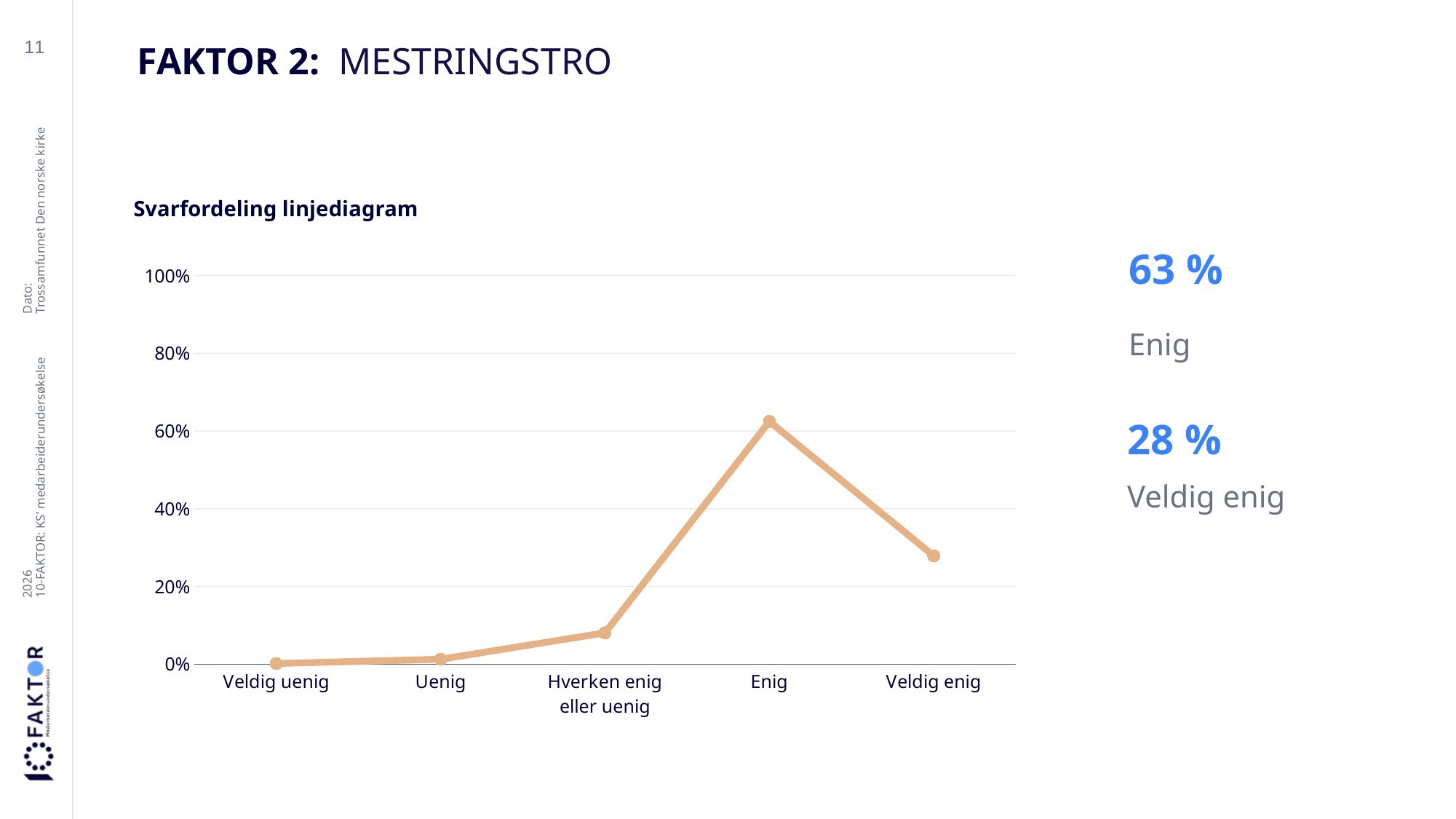
What is the title of the chart? Svarfordeling linjediagram Which is larger, the value for Enig or the value for Veldig enig? Enig Is the value for Hverken enig eller uenig greater or less than 20%? less Is the value for Veldig uenig greater or less than 20%? less What kind of chart is shown on the slide? Line chart What is the difference between the values for Enig and Veldig enig? 35 percentage points What is the value for Veldig enig in the chart? 28 % How many categories are shown on the x axis of the chart? 5 Do the values rise or fall from Hverken enig eller uenig to Enig? Rise Is the value for Enig greater or less than 40%? greater Which category has the highest value in the chart? Enig What is the value for Enig in the chart? 63 %